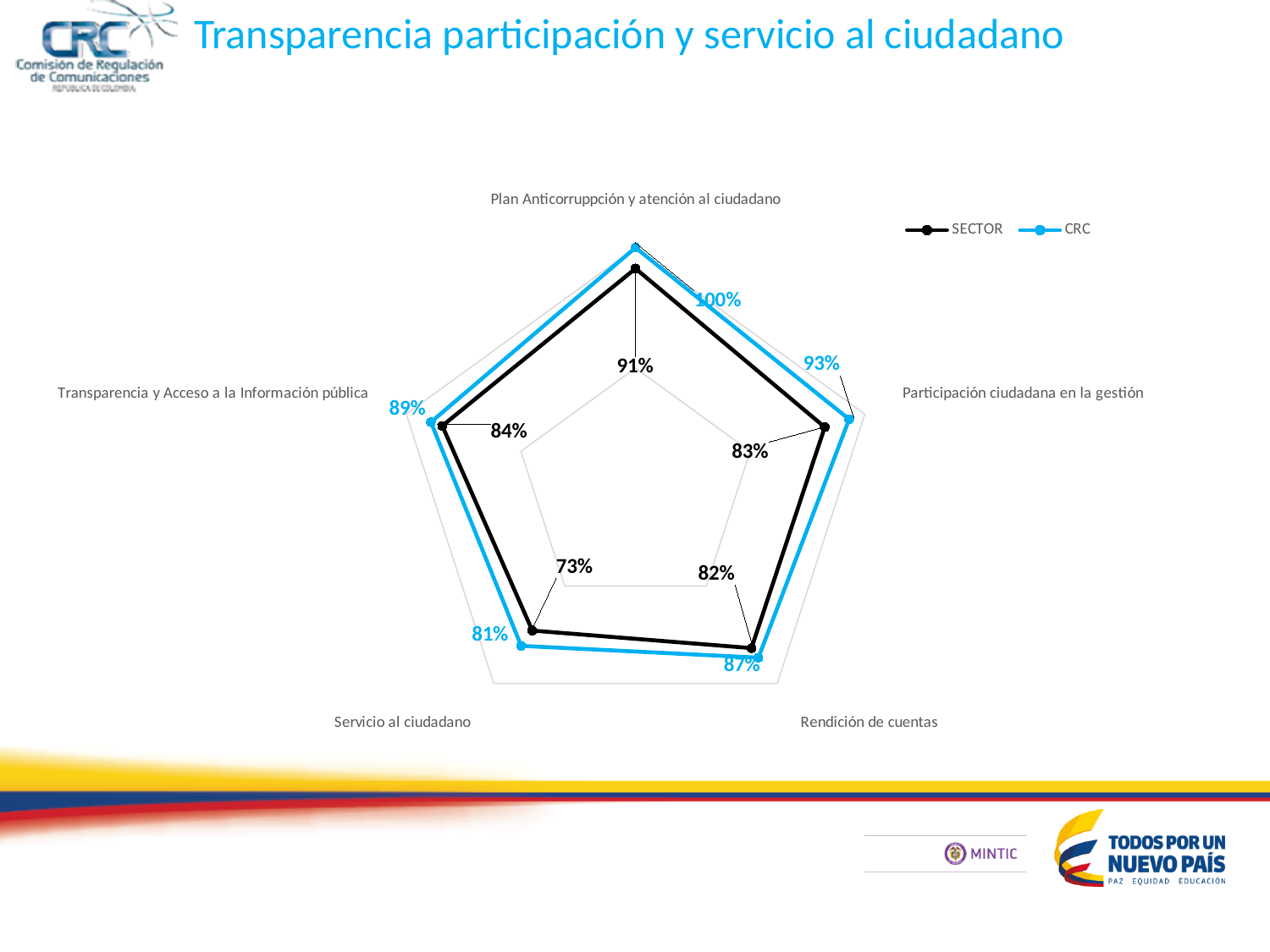
For Rendición de cuentas, which series has the larger value, SECTOR or CRC? CRC What is the CRC value for Participación ciudadana en la gestión? 93% Which colour represents the CRC series in the chart? Blue What is the SECTOR value for Transparencia y Acceso a la Información pública? 84% How many series does the legend list? 2 What kind of chart is shown on the slide? Radar chart What is the difference between the CRC and SECTOR values for Participación ciudadana en la gestión? 10% Which category has the highest CRC value? Plan Anticorruppción y atención al ciudadano Which category has the lowest SECTOR value? Servicio al ciudadano What is the SECTOR value for Servicio al ciudadano? 73% What is the CRC value for Plan Anticorruppción y atención al ciudadano? 100% How many categories (axes) does the radar chart have? 5